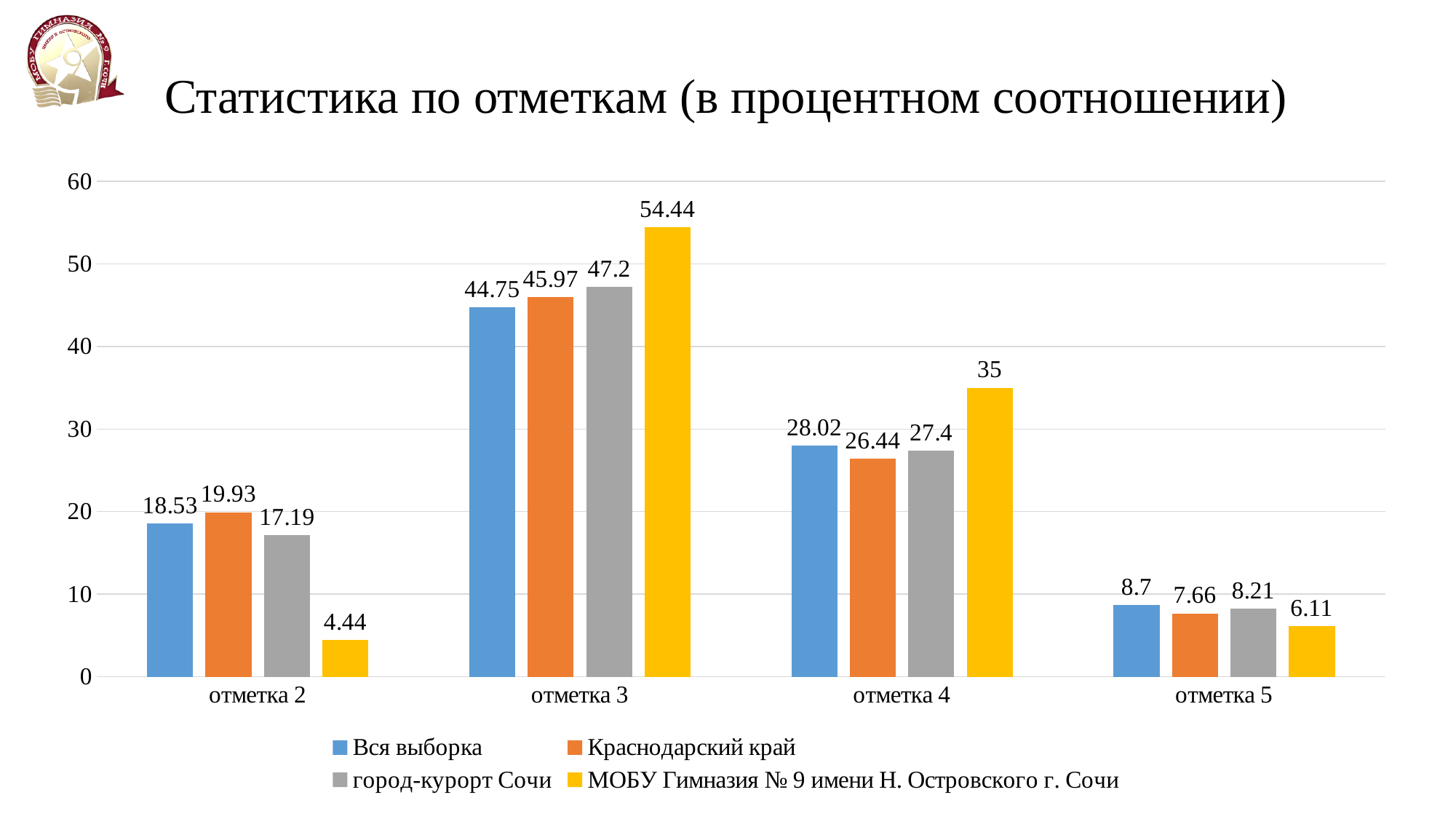
What is the value for МОБУ Гимназия № 9 имени Н. Островского г. Сочи at отметка 3? 54.44 Which series has the lowest value at отметка 2? МОБУ Гимназия № 9 имени Н. Островского г. Сочи What is the title of the slide? Статистика по отметкам (в процентном соотношении) What kind of chart is shown on the slide? bar chart What is the value for город-курорт Сочи at отметка 4? 27.4 Which category has the highest value for the МОБУ Гимназия № 9 имени Н. Островского г. Сочи series? отметка 3 What is the difference between the МОБУ Гимназия № 9 имени Н. Островского г. Сочи value and the Вся выборка value at отметка 4? 6.98 What is the value for Краснодарский край at отметка 5? 7.66 Which is larger at отметка 5: Вся выборка or город-курорт Сочи? Вся выборка What is the value for Вся выборка at отметка 2? 18.53 How many categories are shown on the x axis? 4 How many series does the legend list? 4